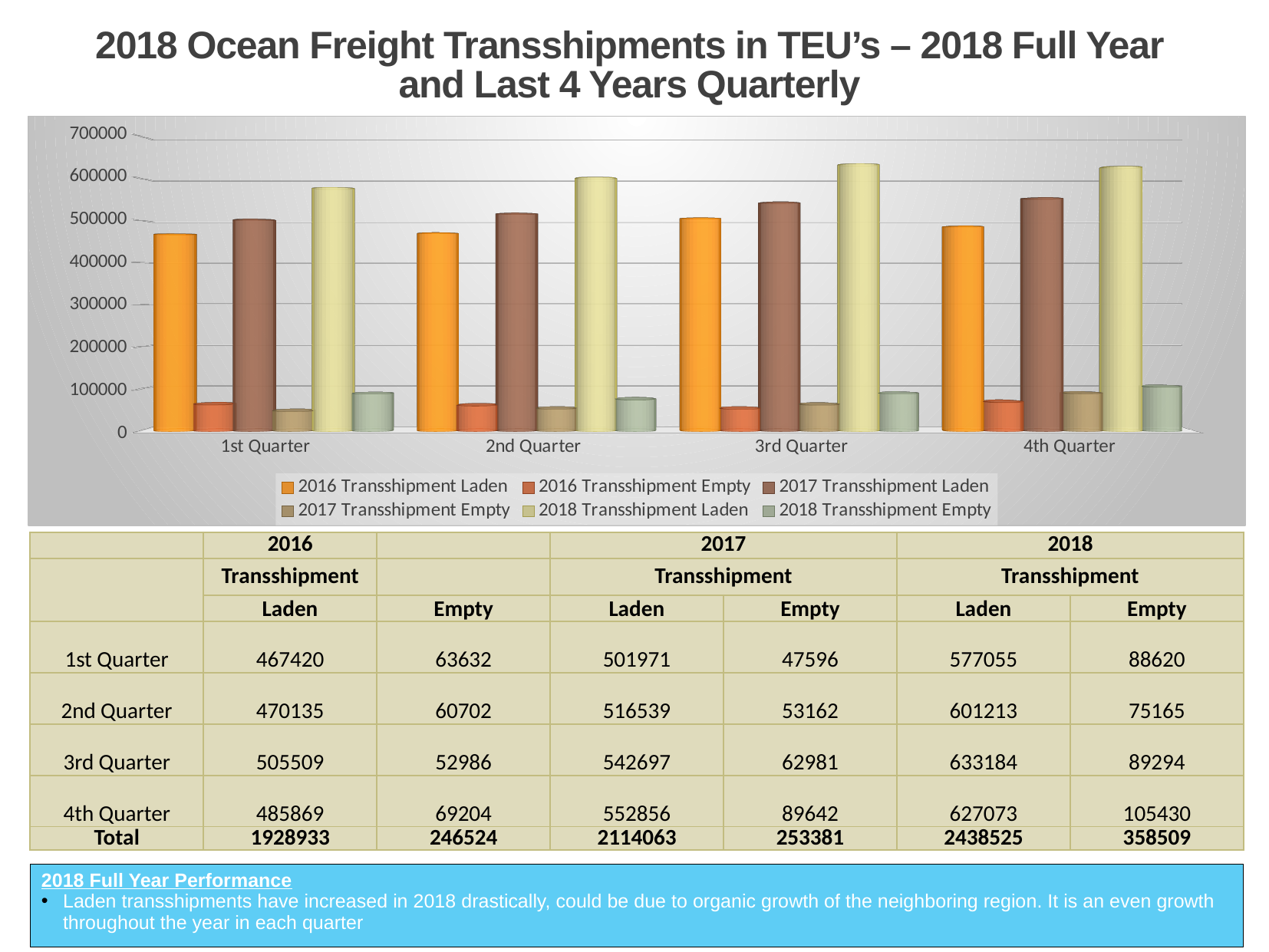
Which colour represents 2018 Transshipment Laden in the chart legend? light yellow In which quarter is 2018 Transshipment Laden highest? 3rd Quarter What is the value of 2016 Transshipment Empty in the 4th Quarter? 69204 How many series does the chart legend list? 6 What is the difference between 2018 Transshipment Laden and 2017 Transshipment Laden in the 1st Quarter? 75084 Does 2017 Transshipment Laden rise or fall from the 1st Quarter to the 4th Quarter? rise Which is larger in the 2nd Quarter: 2016 Transshipment Laden or 2017 Transshipment Laden? 2017 Transshipment Laden In which quarter is 2017 Transshipment Empty lowest? 1st Quarter Is the value for 2018 Transshipment Laden in the 2nd Quarter greater or less than 600000? greater What is the value of 2018 Transshipment Laden in the 3rd Quarter? 633184 What kind of chart is shown on the slide? bar chart How many quarters are shown on the x axis of the chart? 4